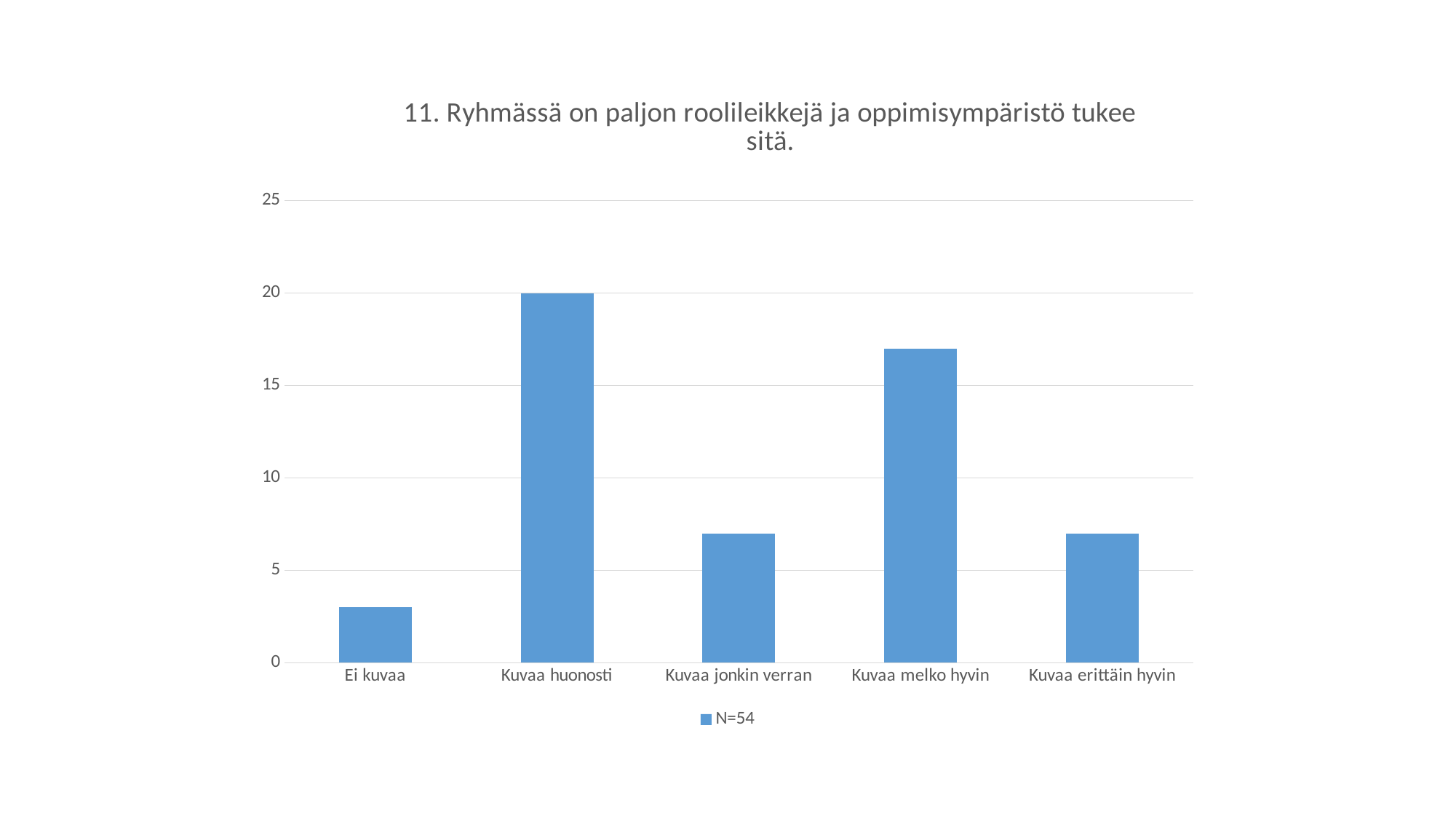
How many categories are shown on the x axis? 5 How many series does the legend list? 1 What is the value for Kuvaa huonosti? 20 Is the value for Ei kuvaa greater or less than 5? less Is the value for Kuvaa melko hyvin greater or less than 15? greater What type of chart is shown on the slide? Bar chart What is the legend entry shown below the chart? N=54 Which is larger, the value for Kuvaa huonosti or the value for Kuvaa melko hyvin? Kuvaa huonosti Which category has the lowest value? Ei kuvaa Which category has the highest value? Kuvaa huonosti Which is larger, the value for Ei kuvaa or the value for Kuvaa jonkin verran? Kuvaa jonkin verran Is the value for Kuvaa erittäin hyvin greater or less than 10? less